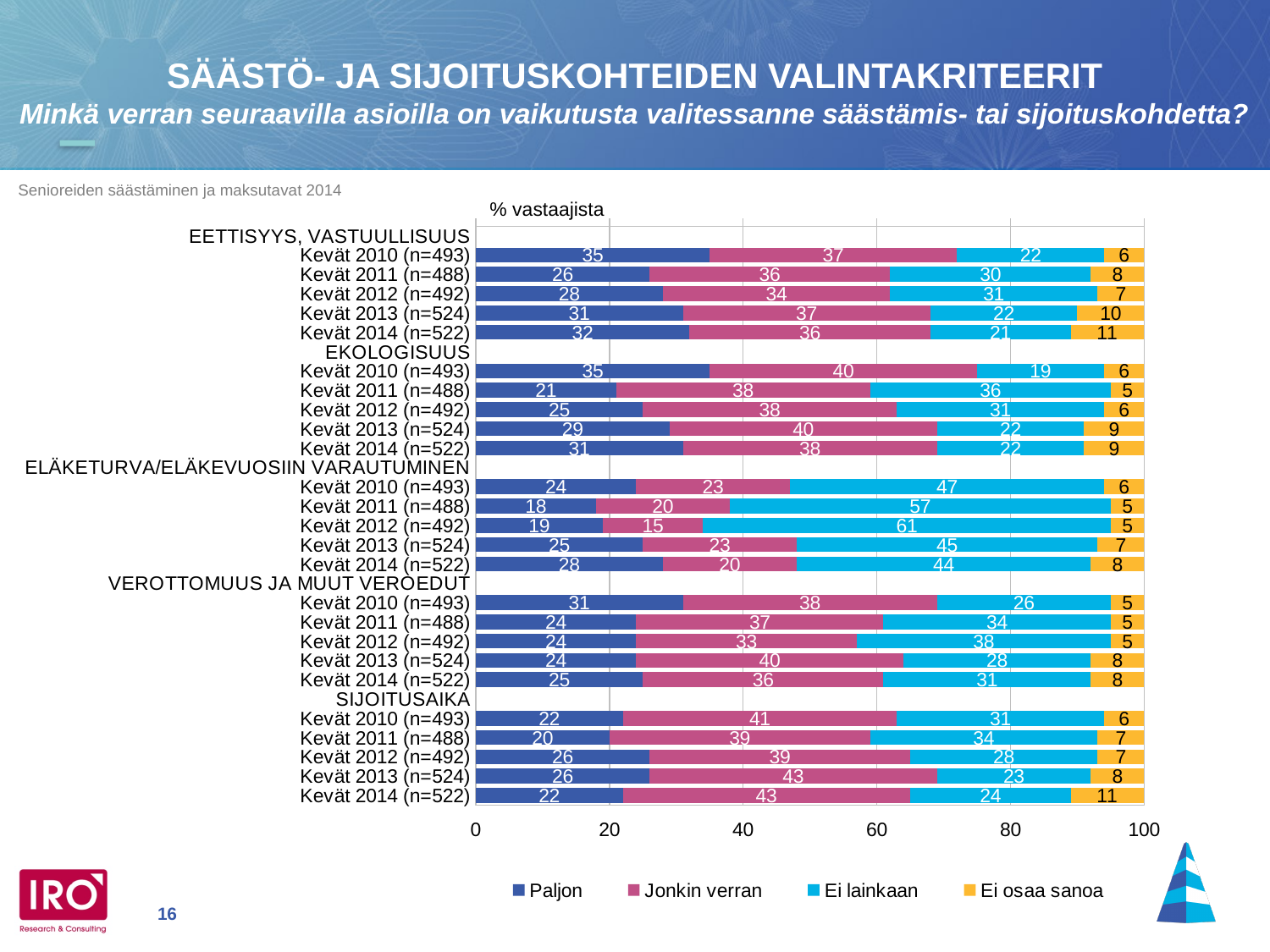
What is the value of "Paljon" for Kevät 2010 (n=493) under EETTISYYS, VASTUULLISUUS? 35 What is the difference between the "Paljon" values for Kevät 2010 (n=493) and Kevät 2011 (n=488) under EKOLOGISUUS? 14 What is the value of "Jonkin verran" for Kevät 2014 (n=522) under SIJOITUSAIKA? 43 How many series does the legend list? 4 What kind of chart is shown on the slide? Stacked bar chart What is the total of the stacked bar for Kevät 2013 (n=524) under SIJOITUSAIKA? 100 Under VEROTTOMUUS JA MUUT VEROEDUT, is the "Jonkin verran" value larger for Kevät 2013 (n=524) or Kevät 2012 (n=492)? Kevät 2013 (n=524) Among the EKOLOGISUUS rows, which year has the lowest "Paljon" value? Kevät 2011 (n=488) Among the ELÄKETURVA/ELÄKEVUOSIIN VARAUTUMINEN rows, which year has the highest "Ei lainkaan" value? Kevät 2012 (n=492) What is the value of "Ei osaa sanoa" for Kevät 2014 (n=522) under EETTISYYS, VASTUULLISUUS? 11 What is the label shown above the chart's plot area? % vastaajista What is the value of "Ei lainkaan" for Kevät 2012 (n=492) under ELÄKETURVA/ELÄKEVUOSIIN VARAUTUMINEN? 61